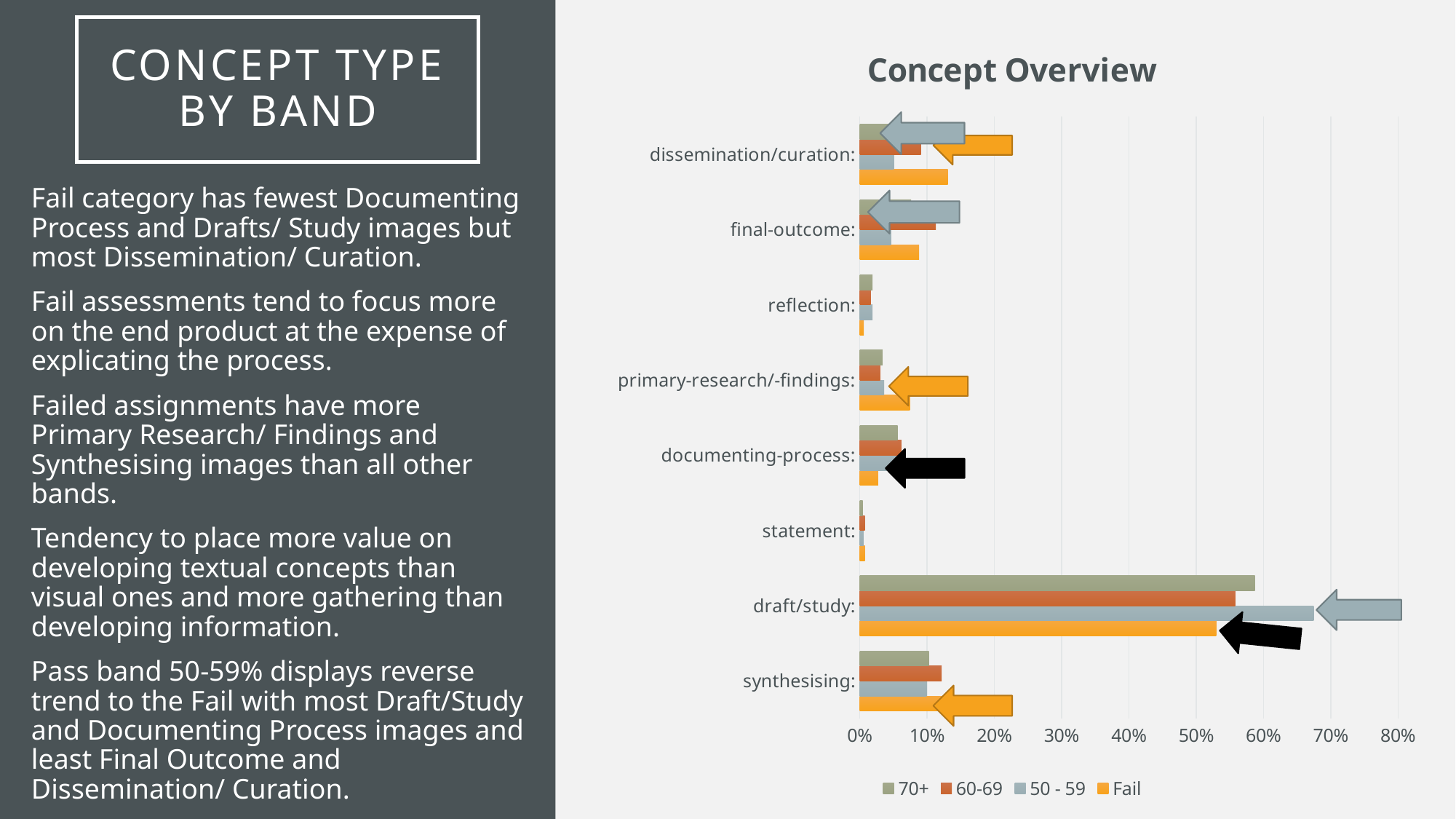
Is the value for draft/study in the 50 - 59 series greater or less than 60%? greater For draft/study, which series has the larger value: 50 - 59 or 60-69? 50 - 59 How many series does the chart legend list? 4 How many categories are shown on the chart's vertical axis? 8 Is the value for synthesising in the 60-69 series greater or less than 20%? less What is the title of the chart? Concept Overview Which category has the highest value for the 50 - 59 series? draft/study What type of chart is shown on the slide? bar chart Which category has the highest value for the Fail series? draft/study For dissemination/curation, which series has the larger value: Fail or 70+? Fail Which series is shown in orange/yellow in the legend? Fail Is the value for draft/study in the Fail series greater or less than 50%? greater